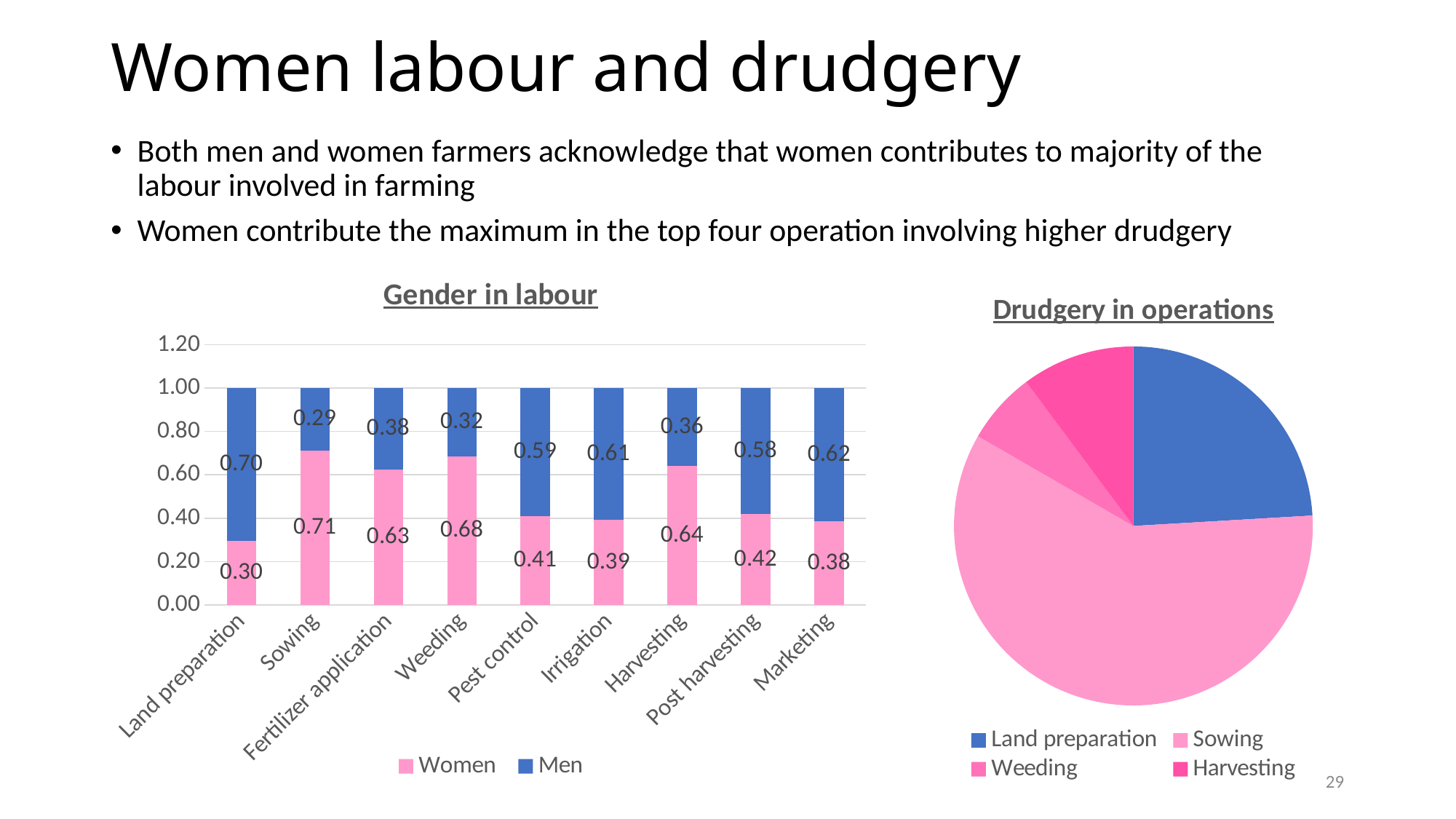
In the Gender in labour chart, what is the value for Men in Land preparation? 0.70 In the Gender in labour chart, what is the value for Women in Harvesting? 0.64 In the Gender in labour chart, how many categories are shown on the x axis? 9 In the Drudgery in operations chart, which operation has the largest slice? Sowing In the Gender in labour chart, which category has the highest value for Women? Sowing In the Gender in labour chart, which category has the lowest value for Women? Land preparation What kind of chart is the Drudgery in operations chart? Pie chart In the Gender in labour chart, how many series does the legend list? 2 In the Gender in labour chart, which is larger: the Men value for Irrigation or the Men value for Post harvesting? Irrigation In the Gender in labour chart, what is the difference between the Women values for Weeding and Pest control? 0.27 In the Gender in labour chart, what is the value for Women in Sowing? 0.71 In the Drudgery in operations chart, which operation has the smallest slice? Weeding